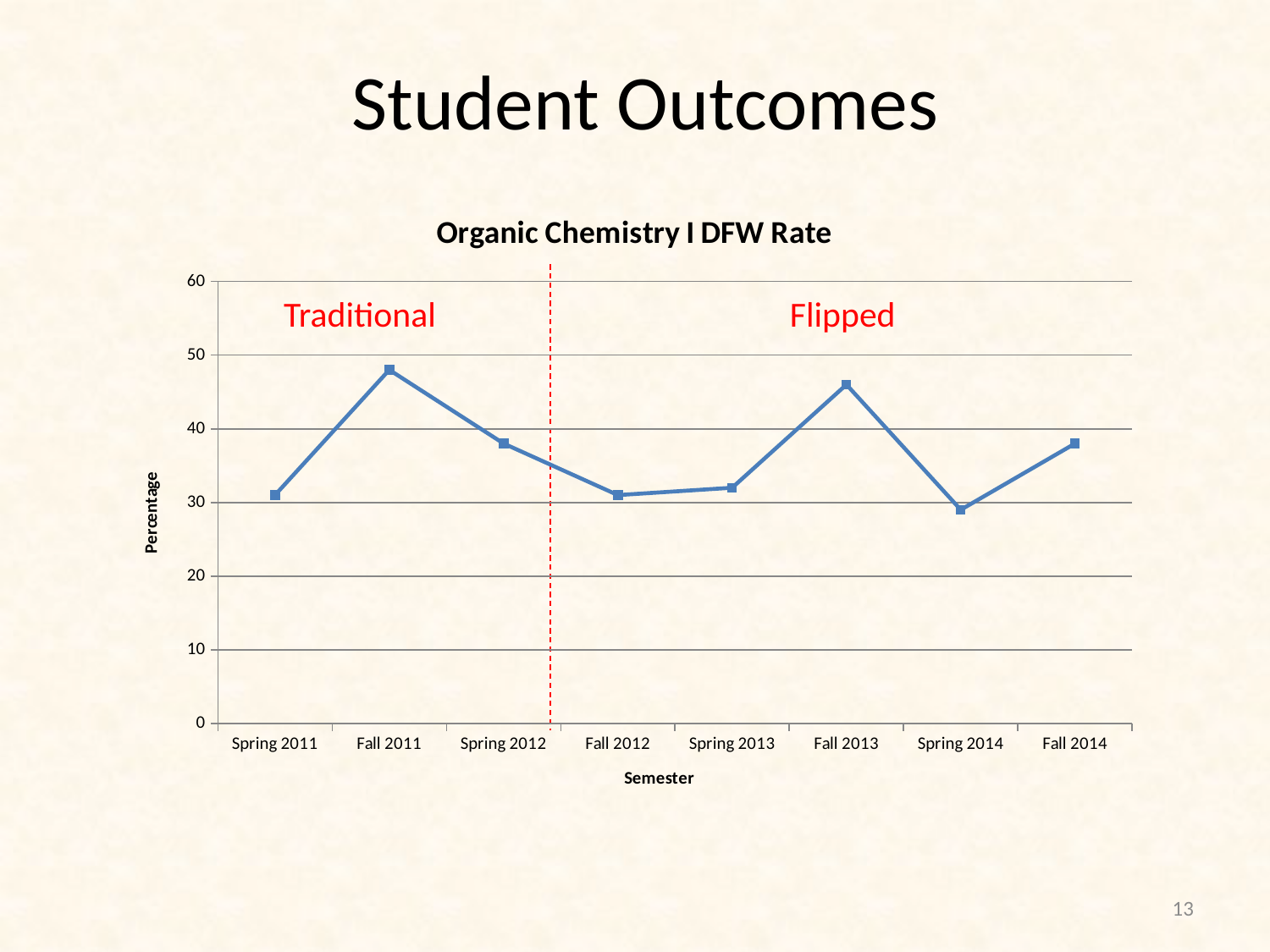
What is the title of the chart? Organic Chemistry I DFW Rate Is the value for Fall 2011 greater or less than 40? greater What is the label on the vertical axis of the chart? Percentage Does the DFW rate rise or fall from Fall 2013 to Spring 2014? fall What kind of chart is shown on the slide? line chart How many semesters are plotted on the x axis? 8 Which is larger, the value for Fall 2011 or the value for Spring 2011? Fall 2011 Which is larger, the value for Fall 2013 or the value for Spring 2014? Fall 2013 Is the value for Spring 2014 greater or less than 30? less Which semester has the lowest DFW rate? Spring 2014 Is the value for Spring 2011 greater or less than 40? less